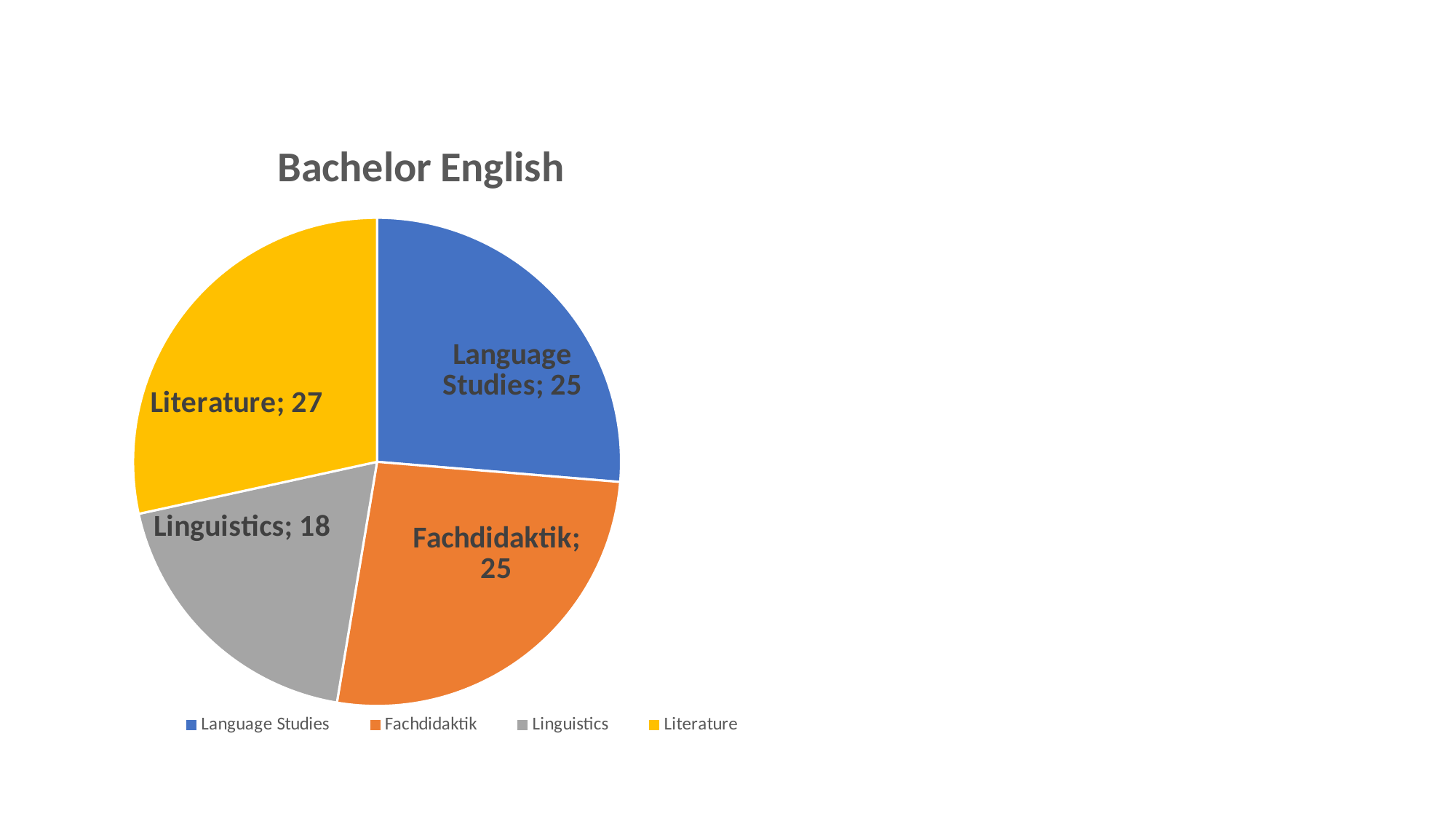
What is the difference between the values for Literature and Linguistics? 9 Which category has the largest slice in the Bachelor English pie chart? Literature What is the difference between the values for Literature and Language Studies? 2 What is the title of the chart on the slide? Bachelor English What kind of chart is shown on the slide? Pie chart What is the value for Fachdidaktik in the Bachelor English pie chart? 25 What is the value for Literature in the Bachelor English pie chart? 27 How many categories are shown in the Bachelor English pie chart? 4 What is the value for Linguistics in the Bachelor English pie chart? 18 Which is larger, the value for Literature or the value for Linguistics? Literature Which category has the smallest slice in the Bachelor English pie chart? Linguistics